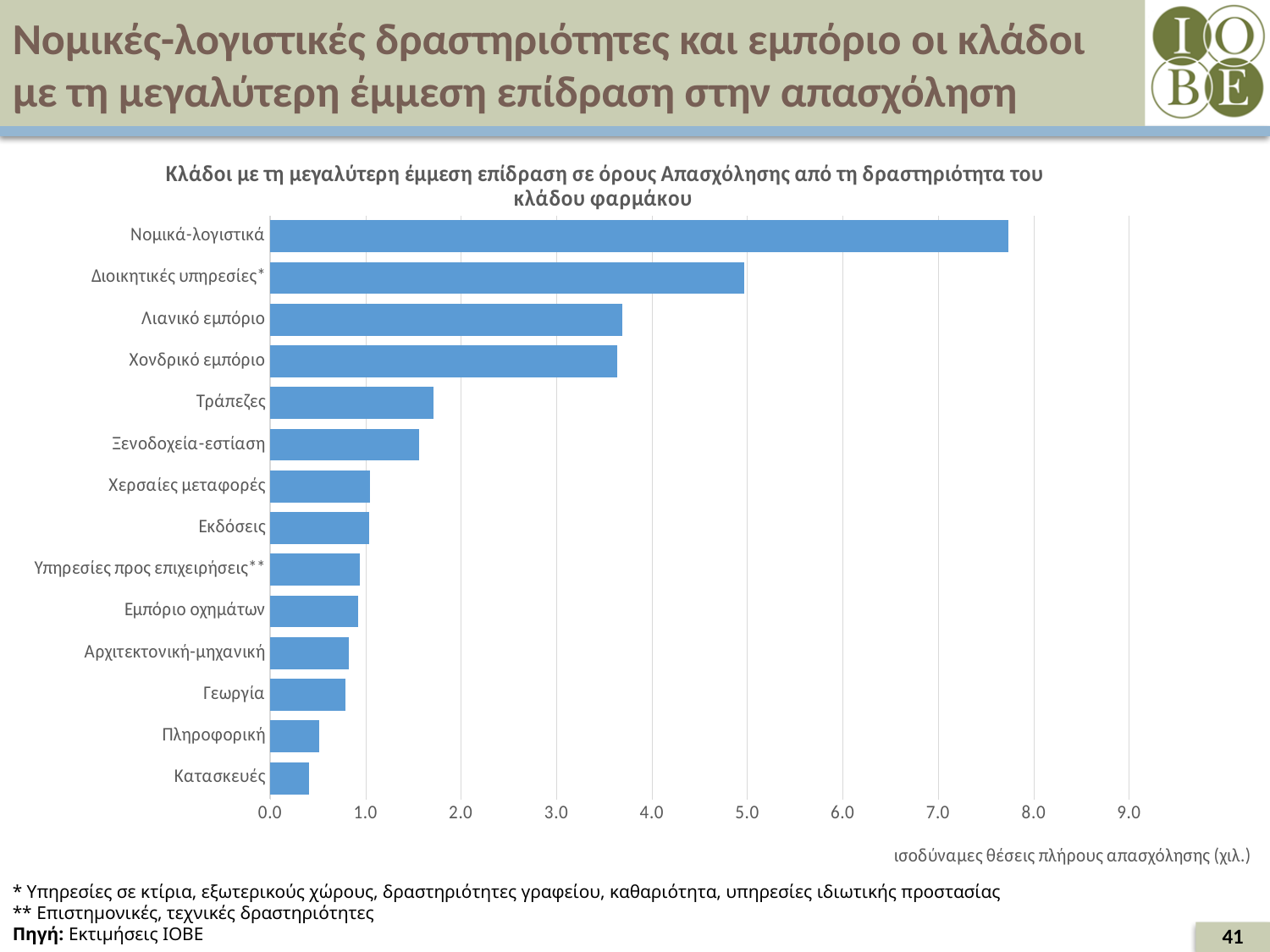
Which has the larger value, Τράπεζες or Ξενοδοχεία-εστίαση? Τράπεζες What unit is given for the horizontal axis of the chart? ισοδύναμες θέσεις πλήρους απασχόλησης (χιλ.) Is the value for Λιανικό εμπόριο greater or less than 3.0? greater Is the value for Νομικά-λογιστικά greater or less than 7.0? greater Which has the larger value, Νομικά-λογιστικά or Διοικητικές υπηρεσίες*? Νομικά-λογιστικά Which sector has the lowest value in the chart? Κατασκευές Which sector has the highest value in the chart? Νομικά-λογιστικά How many sectors (categories) are plotted in the chart? 14 Is the value for Διοικητικές υπηρεσίες* greater or less than 4.0? greater What kind of chart is shown on the slide? Bar chart